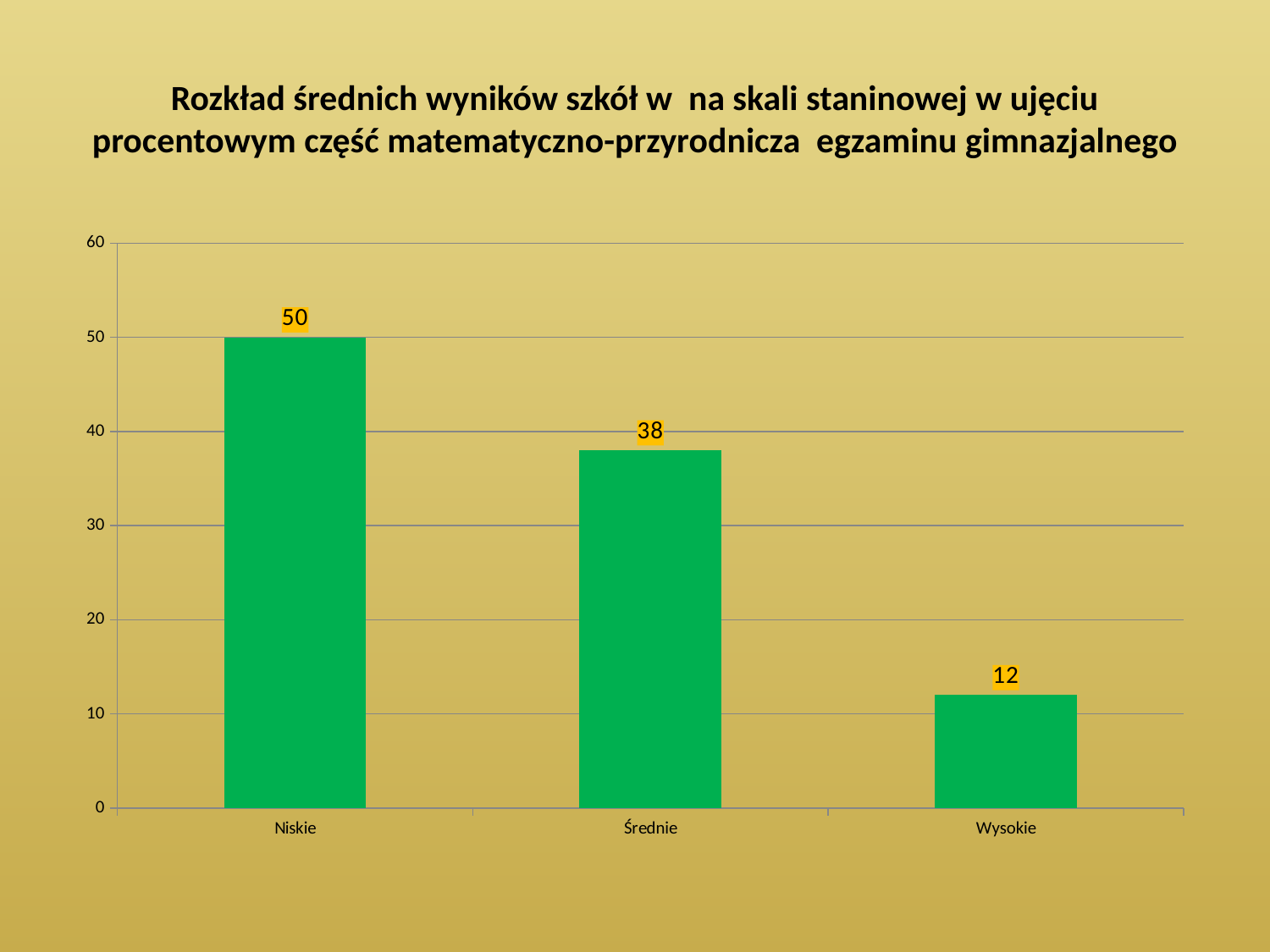
What is the value for Niskie? 50 Is the value for Średnie greater or less than 40? less Which category has the lowest value? Wysokie How many categories are shown on the x axis? 3 What is the value for Wysokie? 12 Which category has the highest value? Niskie Do the values rise or fall from Niskie to Wysokie along the x axis? fall What kind of chart is shown on the slide? bar chart What is the difference between the values for Średnie and Wysokie? 26 Which is larger, the value for Średnie or the value for Wysokie? Średnie What is the difference between the values for Niskie and Średnie? 12 What is the value for Średnie? 38